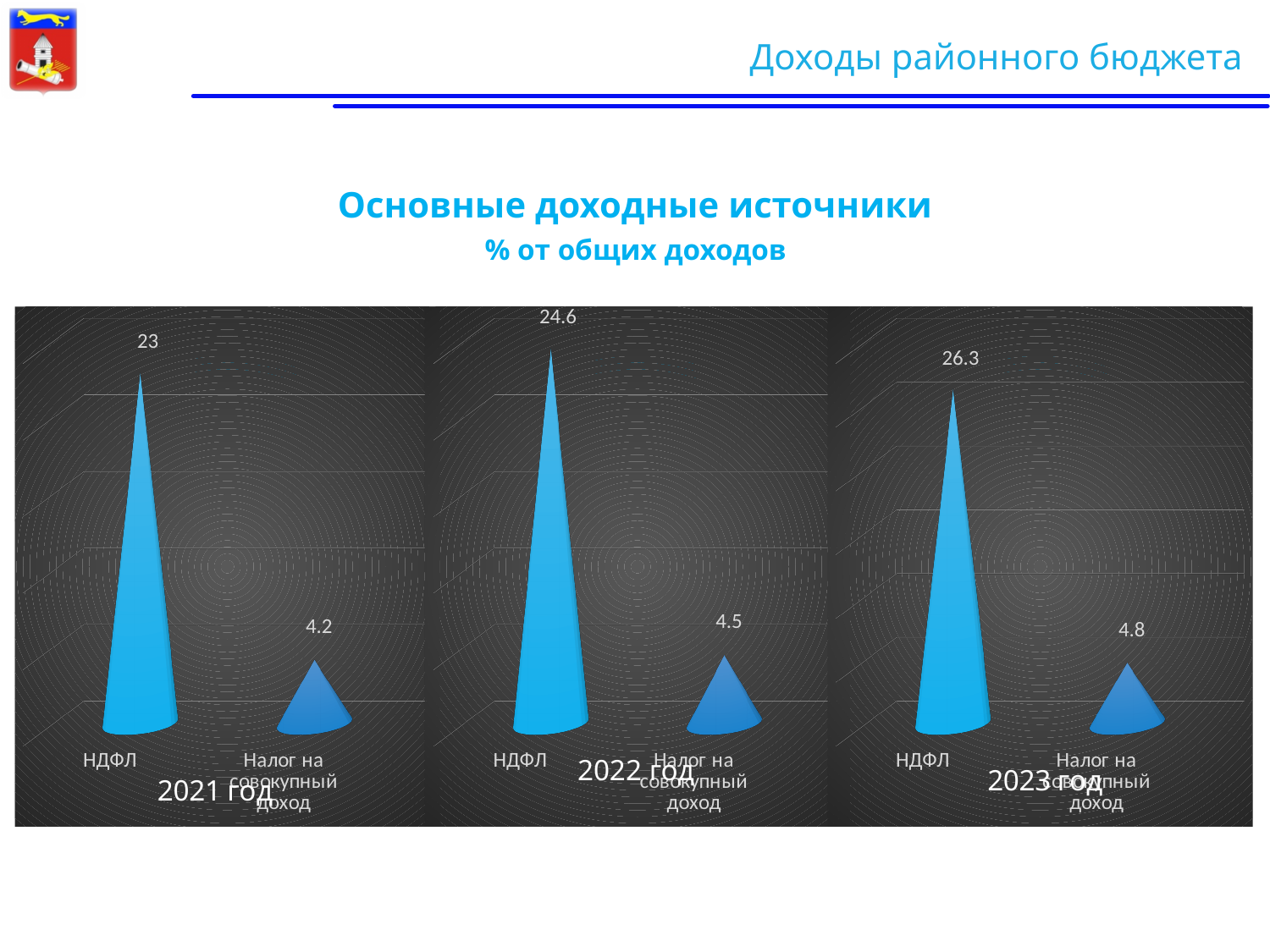
In the 2022 год chart, what is the value for НДФЛ? 24.6 In the 2022 год chart, which category has the lowest value? Налог на совокупный доход How many charts are shown on the slide? 3 In the 2021 год chart, what is the value for НДФЛ? 23 In the 2023 год chart, which category has the highest value? НДФЛ In the 2023 год chart, what is the difference between the values for НДФЛ and Налог на совокупный доход? 21.5 In the 2021 год chart, what is the value for Налог на совокупный доход? 4.2 In the 2022 год chart, what is the difference between the values for НДФЛ and Налог на совокупный доход? 20.1 What kind of chart is the 2022 год chart? bar chart Which is larger: the value for НДФЛ in the 2021 год chart or the value for НДФЛ in the 2023 год chart? НДФЛ in the 2023 год chart In the 2023 год chart, what is the value for Налог на совокупный доход? 4.8 How many categories are shown in the 2021 год chart? 2